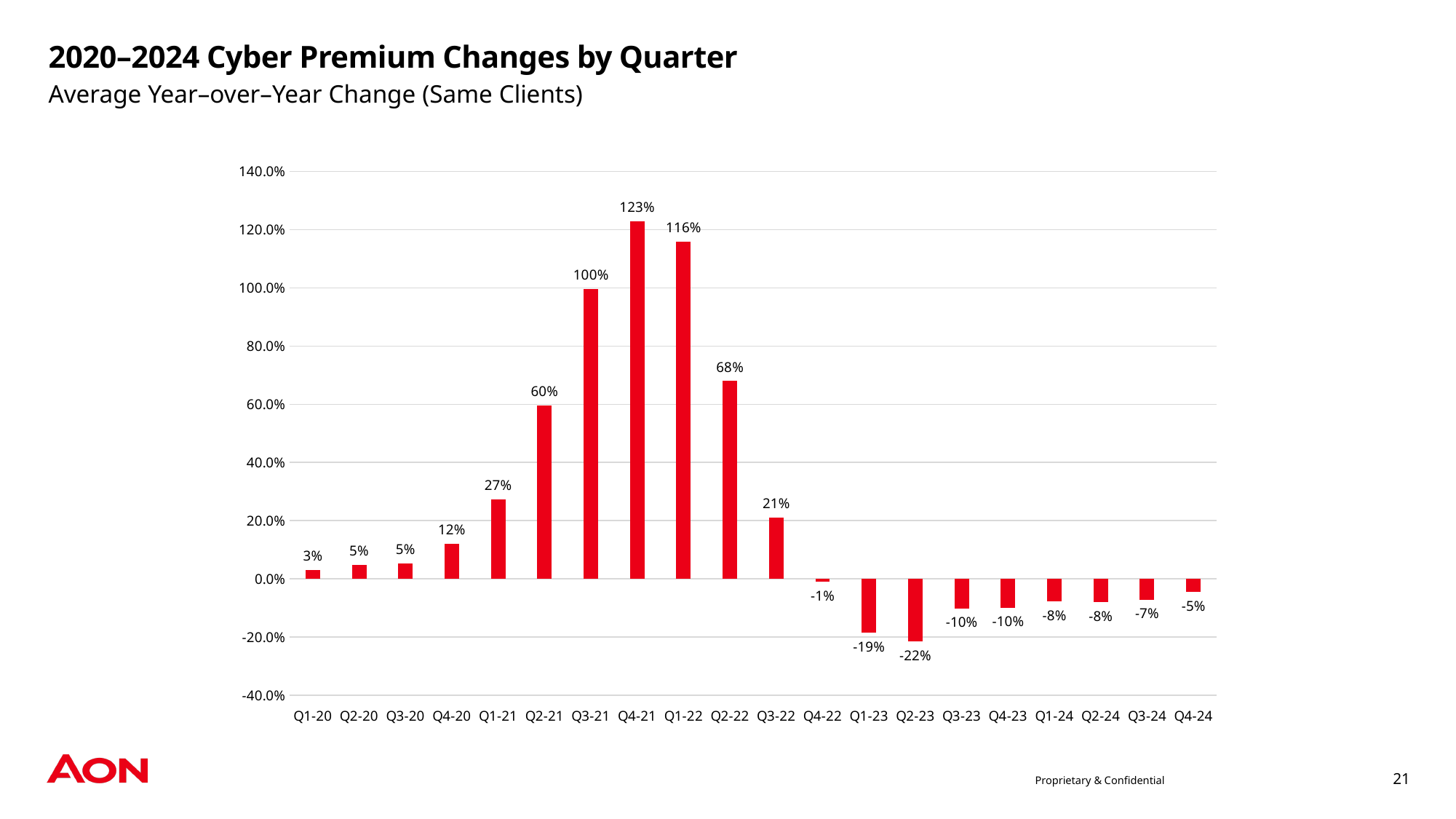
What is the value shown for Q2-23? -22% Which quarter has the lowest year-over-year change? Q2-23 What kind of chart is shown on the slide? Bar chart What is the difference in percentage points between the values for Q4-21 and Q1-22? 7 percentage points Which is larger, the value for Q2-21 or the value for Q2-22? Q2-22 Which quarter has the highest year-over-year change? Q4-21 What is the value shown for Q1-20? 3% Do the values rise or fall from Q4-21 to Q2-23? Fall How many quarters are plotted on the chart? 20 Is the value for Q3-21 greater or less than 80.0%? greater What is the average year-over-year change for Q4-21? 123% What is the subtitle shown below the chart title? Average Year–over–Year Change (Same Clients)